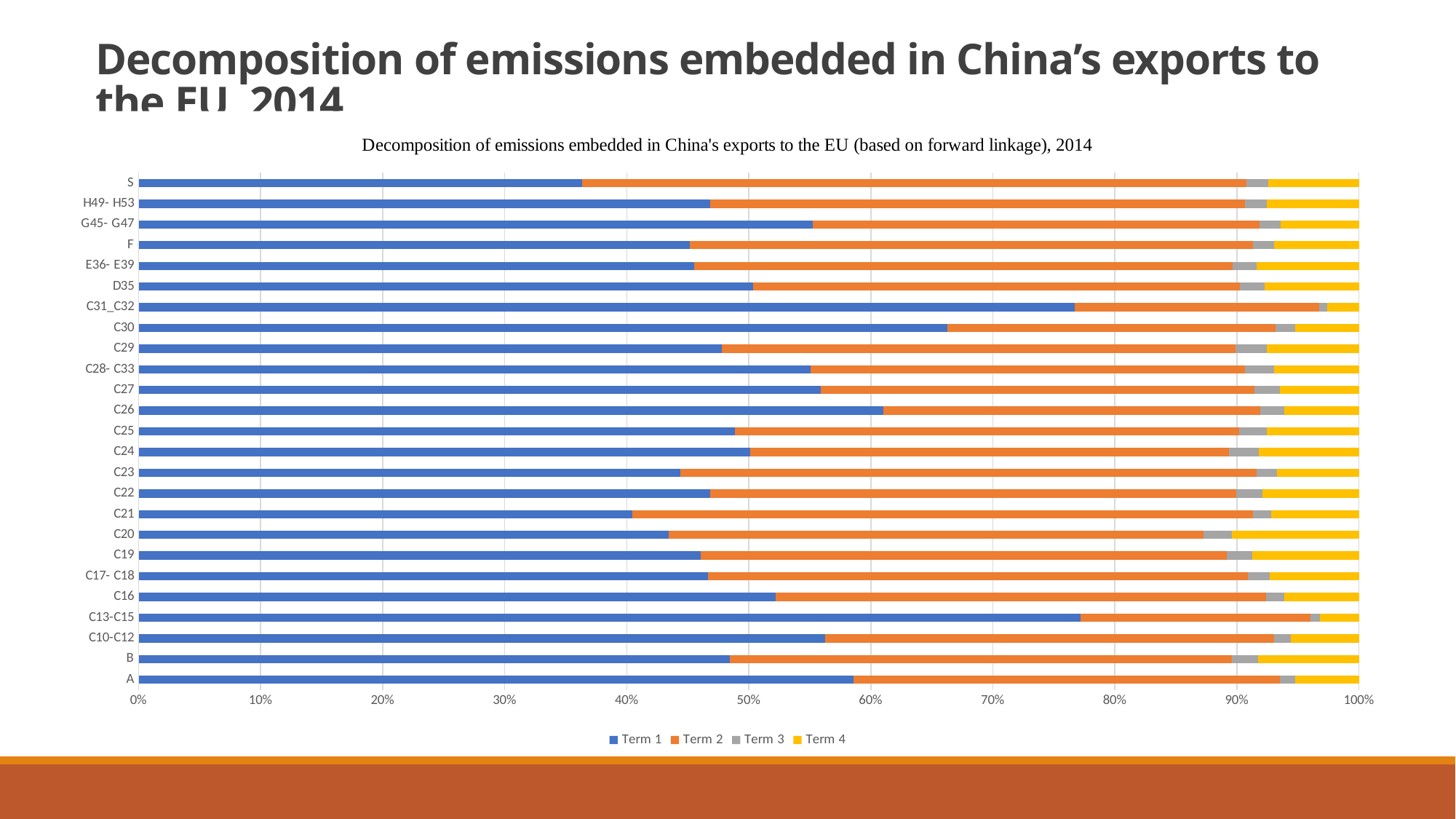
Is the Term 1 share for C20 greater or less than 50%? less Is the Term 1 share for S greater or less than 40%? less Is the Term 1 share for C13-C15 greater or less than 70%? greater What kind of chart is shown on the slide? Stacked bar chart How many series does the legend list? 4 Which has the larger Term 1 share, S or A? A Which has the larger Term 1 share, C30 or C29? C30 Which category has the smallest Term 1 share? S How many categories are plotted on the vertical axis? 25 What are the four legend entries of the chart? Term 1, Term 2, Term 3, Term 4